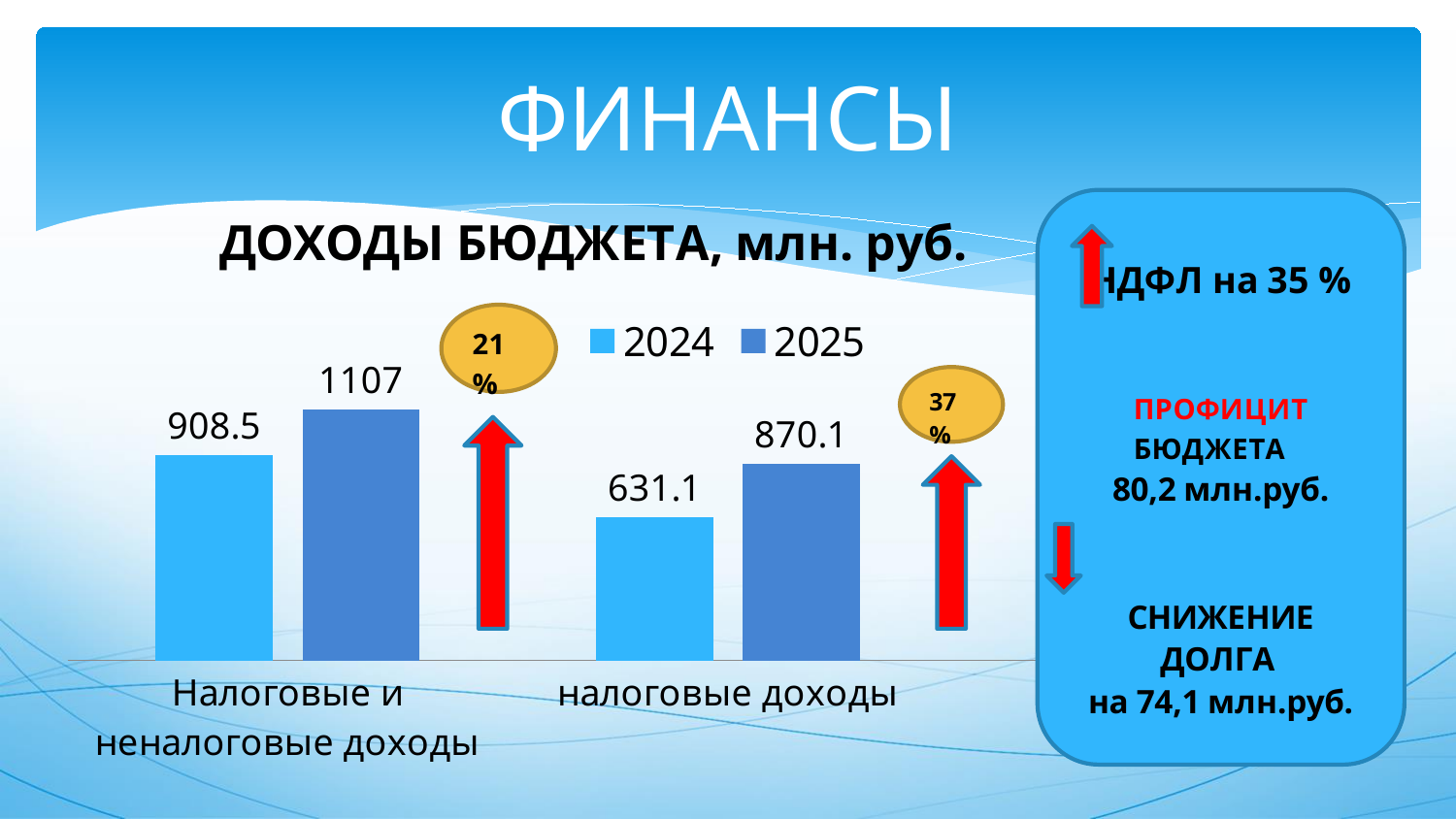
What is the title of the chart? ДОХОДЫ БЮДЖЕТА, млн. руб. What is the 2025 value for "налоговые доходы"? 870.1 What type of chart is shown on the slide? Bar chart How many series does the chart legend list? 2 Which series has the lowest value for "налоговые доходы"? 2024 Which is larger: the 2024 value for "Налоговые и неналоговые доходы" or the 2025 value for "налоговые доходы"? 2024 value for Налоговые и неналоговые доходы Which category has the highest 2025 value? Налоговые и неналоговые доходы What is the 2024 value for "Налоговые и неналоговые доходы"? 908.5 How many categories are shown on the x axis of the chart? 2 What is the difference between the 2025 and 2024 values for "налоговые доходы"? 239 What is the 2024 value for "налоговые доходы"? 631.1 What is the 2025 value for "Налоговые и неналоговые доходы"? 1107